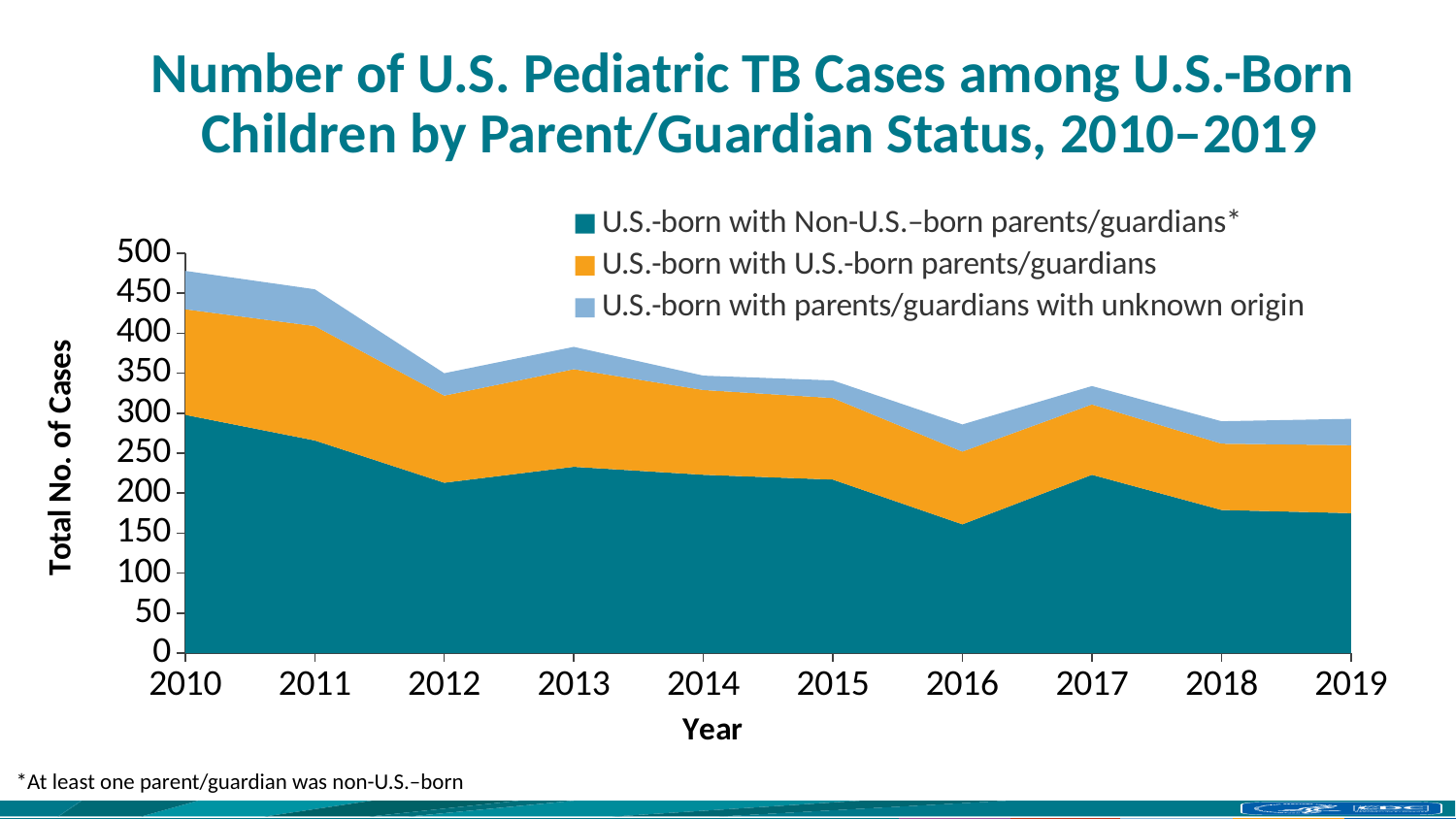
Is the number of cases for U.S.-born children with Non-U.S.-born parents/guardians in 2016 greater or less than 200? less Which year has the lowest number of cases for U.S.-born children with Non-U.S.-born parents/guardians? 2016 Which series is shown in dark teal? U.S.-born with Non-U.S.-born parents/guardians How many years are plotted along the x axis? 10 Which year has the larger total number of cases, 2010 or 2019? 2010 Is the total number of cases in 2010 greater or less than 450? greater Overall, does the total number of cases rise or fall from 2010 to 2019? fall Is the total number of cases in 2016 greater or less than 300? less What is the label on the y axis? Total No. of Cases What kind of chart is shown on the slide? Stacked area chart Which year has the highest total number of cases? 2010 How many series does the legend list? 3